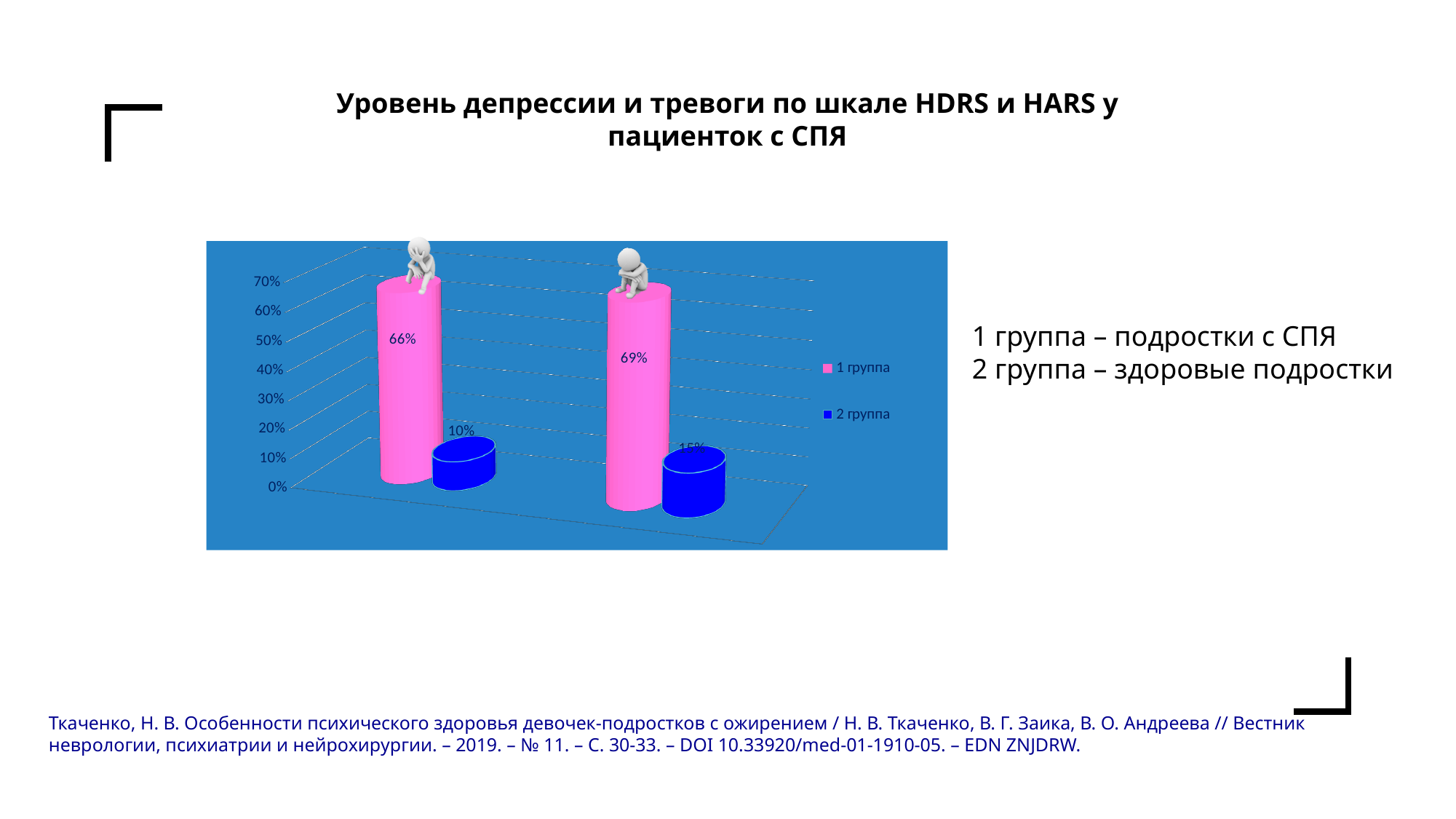
What is the highest value shown in the chart? 69% What colour represents 1 группа in the chart? pink What is the value for 1 группа in the right group of bars? 69% What is the difference between the 1 группа and 2 группа values in the left group of bars? 56% What kind of chart is shown on the slide? bar chart How many series does the chart legend list? 2 What is the value for 2 группа in the right group of bars? 15% What is the value for 2 группа in the left group of bars? 10% What is the value for 1 группа in the left group of bars? 66% What is the difference between the 1 группа and 2 группа values in the right group of bars? 54% Which is larger: the 1 группа value in the left group of bars or in the right group of bars? the right group (69%) How many groups of bars (categories) are plotted in the chart? 2